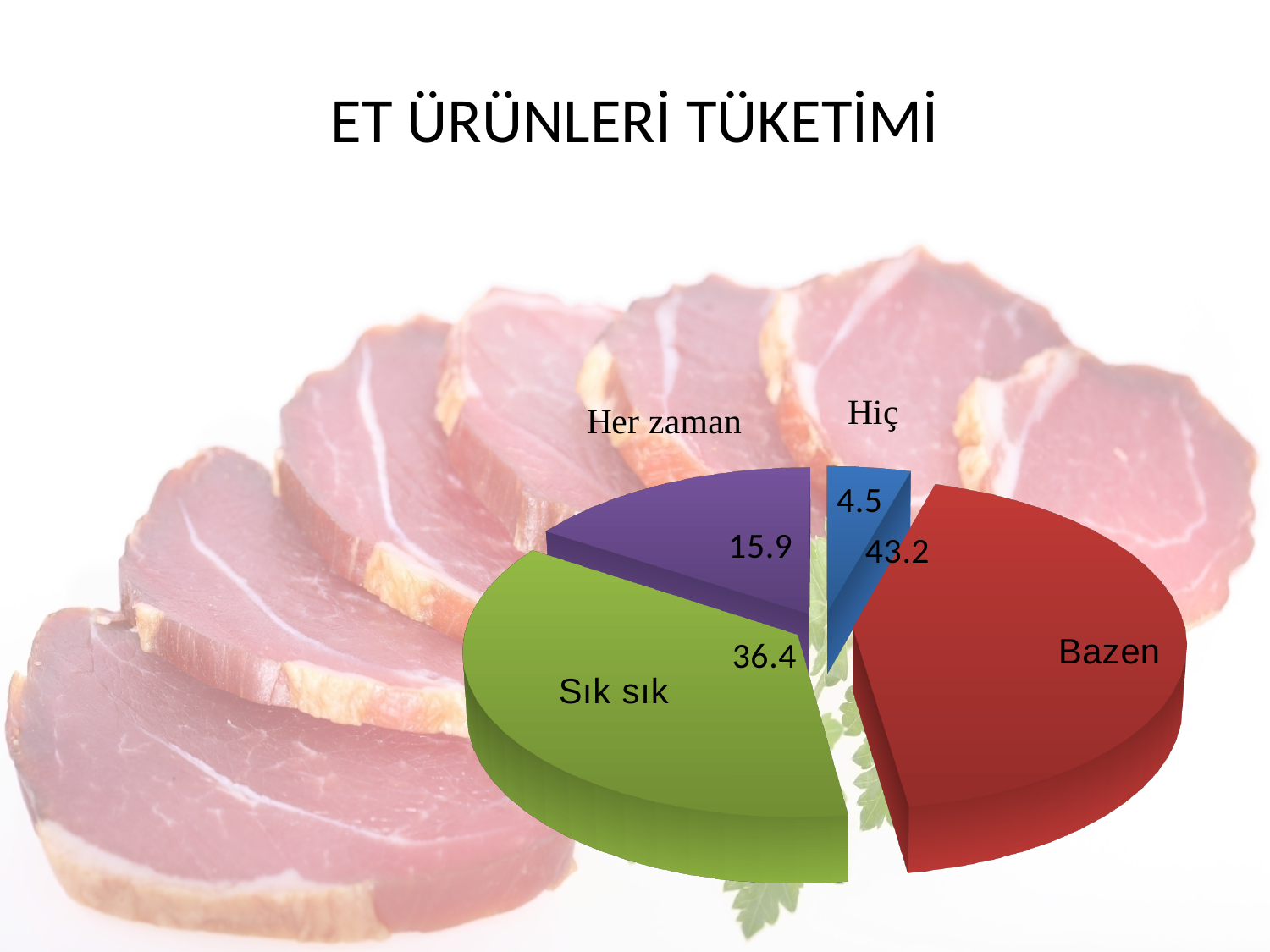
What is the value for Hiç? 4.5 What is the difference between the values for Her zaman and Hiç? 11.4 Which category has the largest slice? Bazen What type of chart is shown on the slide? pie chart What is the value for Sık sık? 36.4 Which category has the smallest slice? Hiç What is the difference between the values for Bazen and Sık sık? 6.8 What is the value for Bazen? 43.2 How many slices does the pie chart have? 4 What is the value for Her zaman? 15.9 What is the title of the slide? ET ÜRÜNLERİ TÜKETİMİ Which is larger, the value for Sık sık or the value for Her zaman? Sık sık